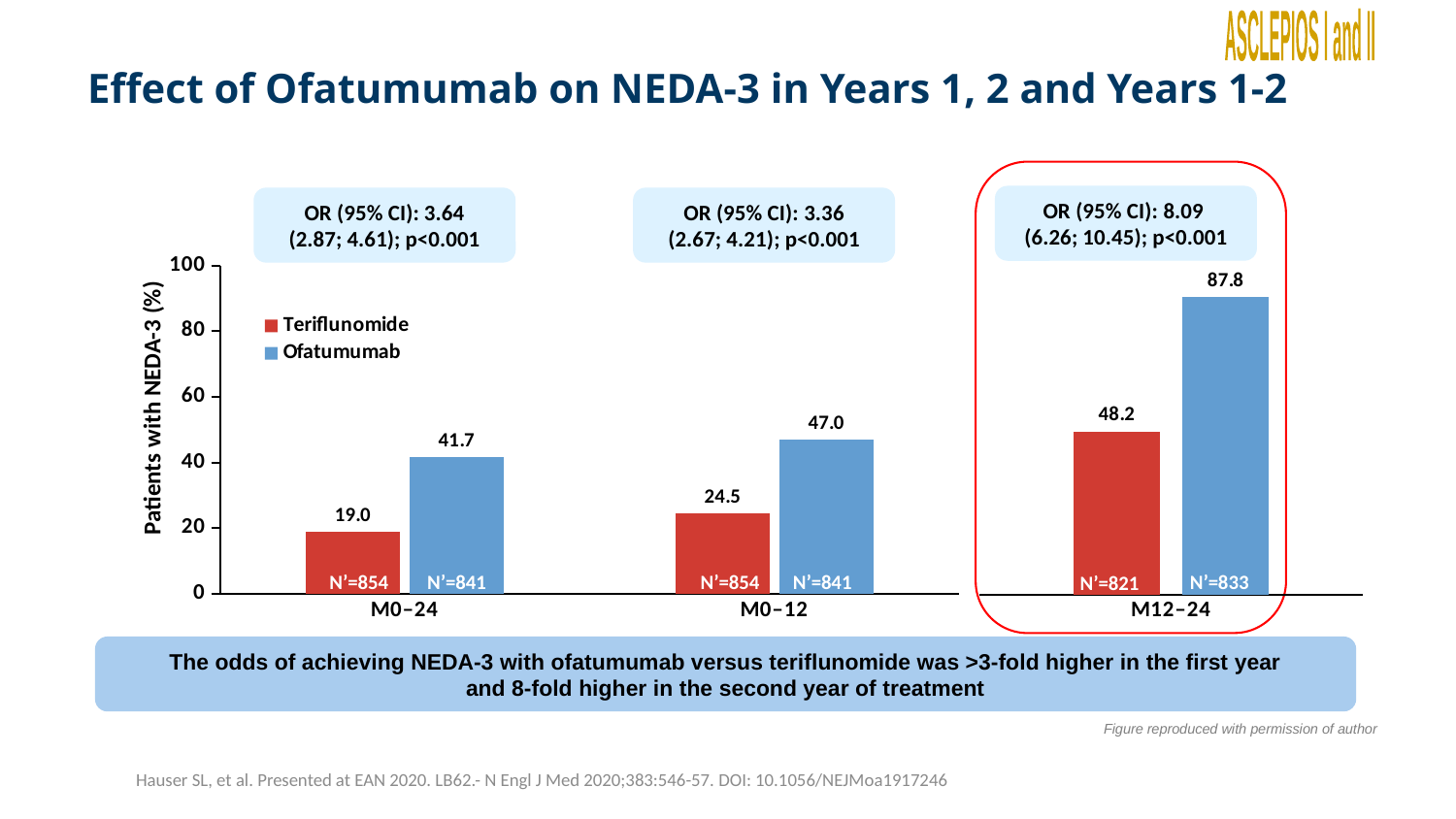
What is the label of the y axis? Patients with NEDA-3 (%) How many groups are shown on the x axis? 3 Which group has the highest Ofatumumab value? M12–24 What is the value for Ofatumumab in the M0–12 group? 47.0 What is the value for Ofatumumab in the M12–24 group? 87.8 What is the value for Teriflunomide in the M0–24 group? 19.0 Which is larger in the M0–12 group, the Teriflunomide value or the Ofatumumab value? Ofatumumab Which group has the lowest Teriflunomide value? M0–24 What kind of chart is shown on the slide? Bar chart What is the difference between the Ofatumumab and Teriflunomide values in the M0–24 group? 22.7 What is the difference between the Ofatumumab and Teriflunomide values in the M12–24 group? 39.6 How many series does the legend list? 2